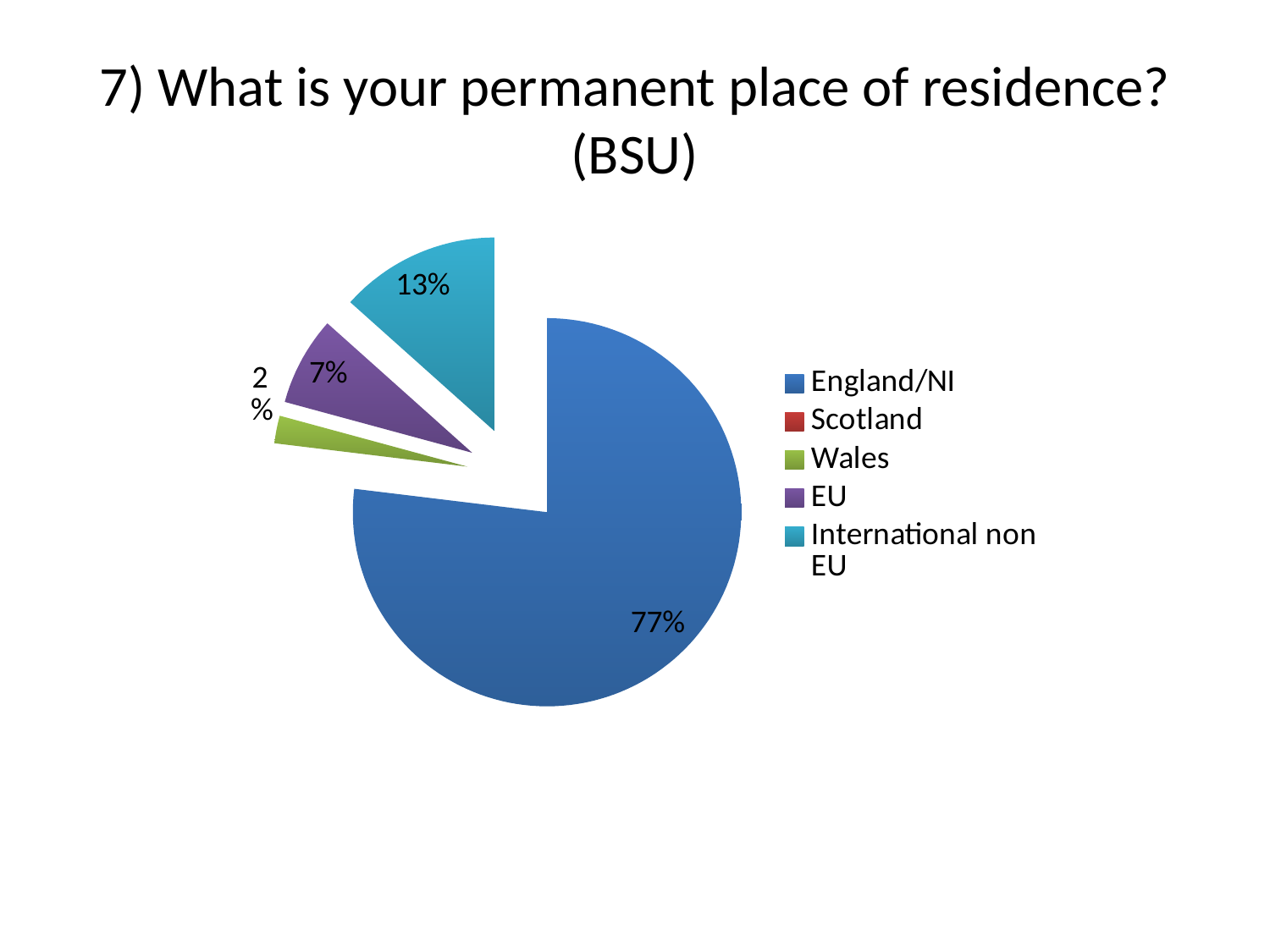
What percentage is shown for International non EU? 13% What is the difference in percentage points between England/NI and International non EU? 64 percentage points What kind of chart is shown on the slide? Pie chart Which category has the largest slice of the pie? England/NI How many categories does the legend list? 5 What colour is the England/NI slice? Blue What share of the pie is England/NI? 77% What percentage is shown for EU? 7% Which is larger, the EU slice or the International non EU slice? International non EU What is the difference in percentage points between International non EU and EU? 6 percentage points What percentage is shown for Wales? 2% What is the title of the slide? 7) What is your permanent place of residence? (BSU)